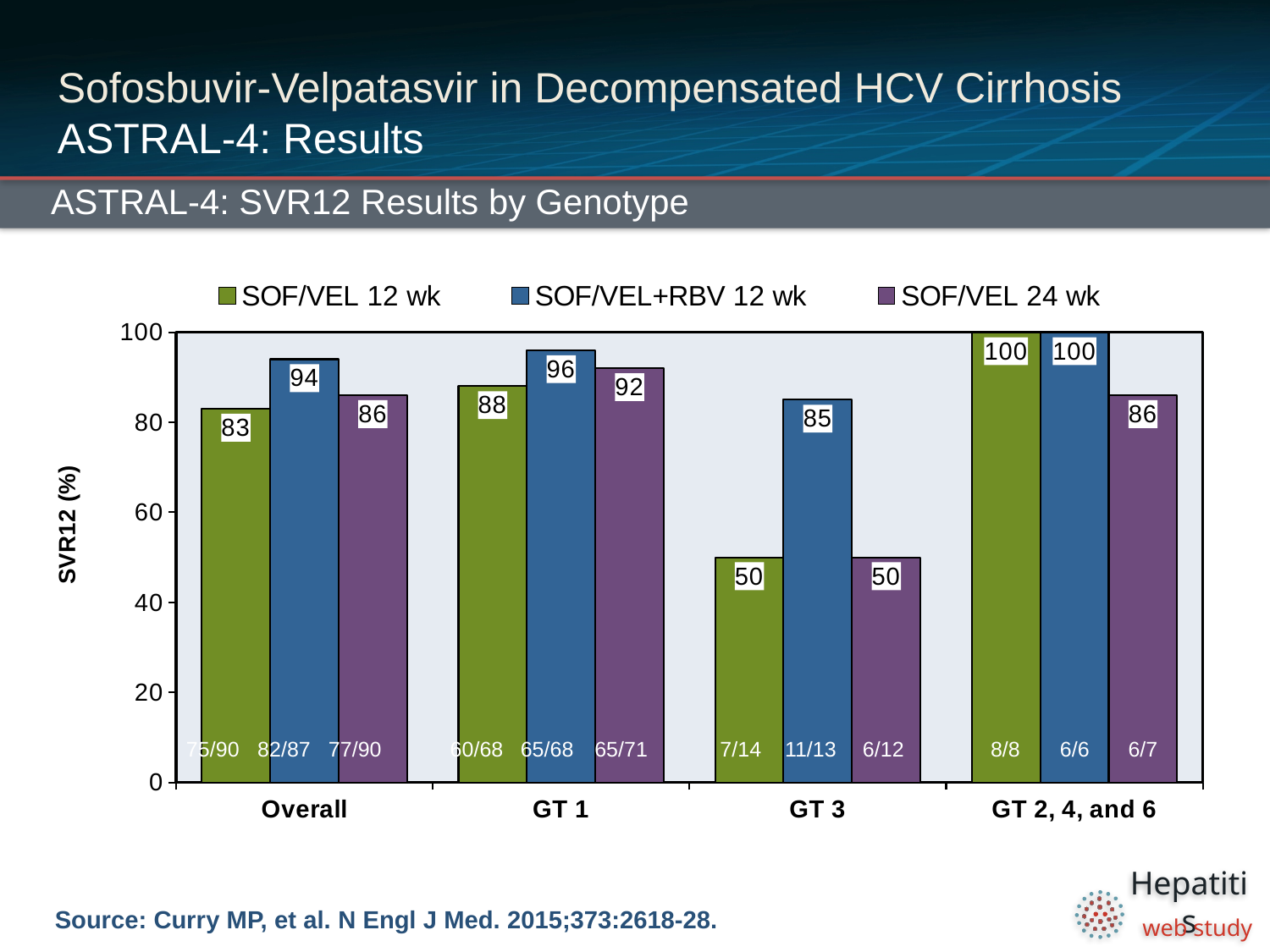
What is the difference in SVR12 (%) between SOF/VEL 24 wk and SOF/VEL 12 wk in the Overall group? 3 What is the label of the y axis? SVR12 (%) Which treatment arm has the highest SVR12 (%) in the Overall group? SOF/VEL+RBV 12 wk What is the SVR12 (%) for SOF/VEL 12 wk in the Overall group? 83 How many genotype groups are shown on the x axis? 4 What kind of chart is shown on the slide? Bar chart How many series does the legend list? 3 Which is larger in the GT 1 group: the SVR12 (%) for SOF/VEL 12 wk or for SOF/VEL 24 wk? SOF/VEL 24 wk What is the SVR12 (%) for SOF/VEL 24 wk in the GT 1 group? 92 What is the difference in SVR12 (%) between SOF/VEL+RBV 12 wk and SOF/VEL 12 wk in the GT 3 group? 35 Which genotype group has the lowest SVR12 (%) for SOF/VEL 12 wk? GT 3 What is the SVR12 (%) for SOF/VEL+RBV 12 wk in the GT 3 group? 85